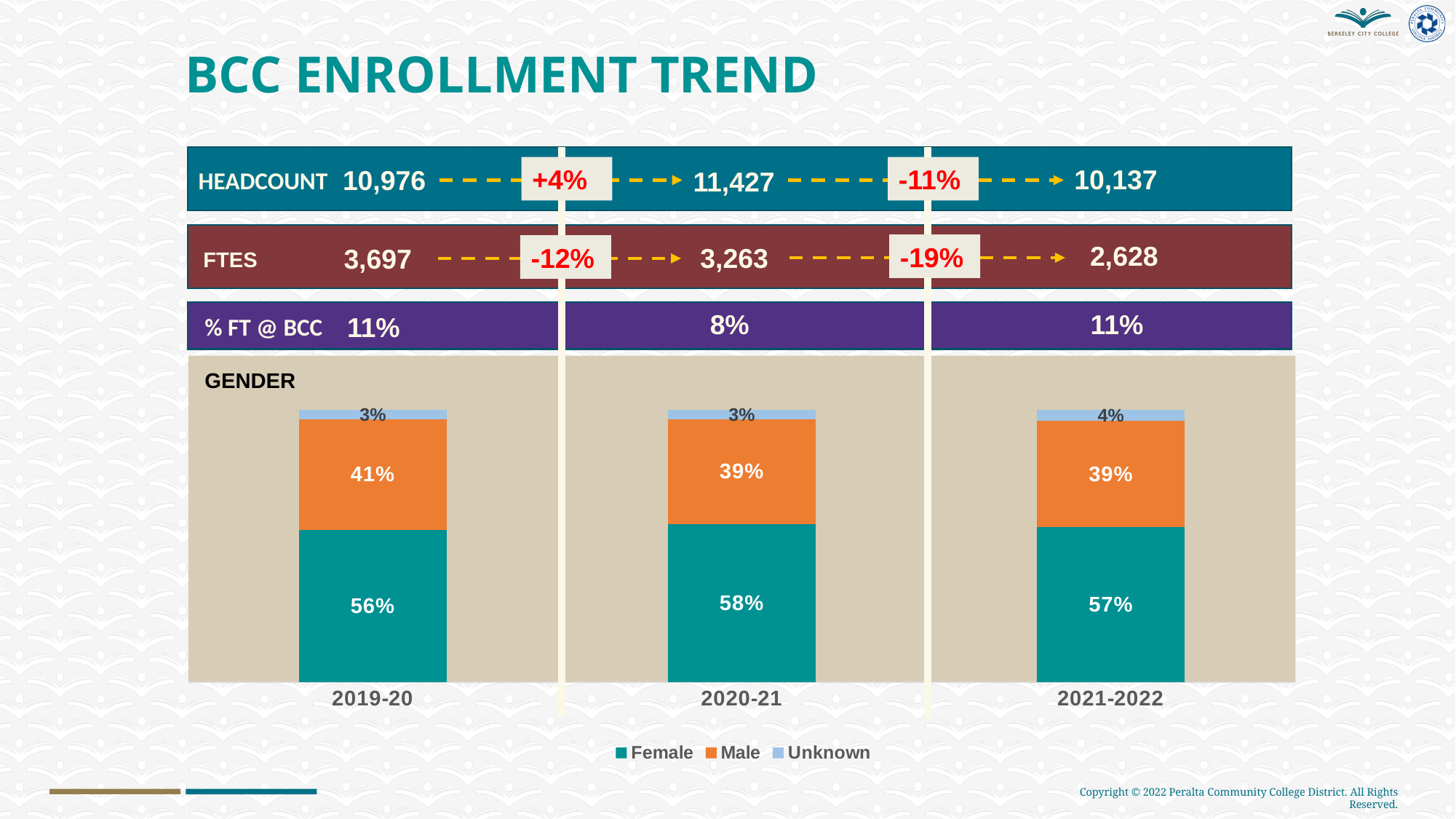
How many academic years are shown on the x axis of the GENDER chart? 3 In the GENDER chart, which year has the highest Female share? 2020-21 In the GENDER chart, what is the Male share for 2019-20? 41% What type of chart is the GENDER chart? stacked bar chart In the GENDER chart, what is the difference between the Female and Male shares in 2021-2022? 18% In the GENDER chart, what is the total of the three segments for the 2019-20 bar? 100% In the GENDER chart, what is the Female share for 2020-21? 58% In the GENDER chart, is the Male share larger in 2019-20 or in 2020-21? 2019-20 In the GENDER chart, which year has the lowest Female share? 2019-20 In the GENDER chart, what is the Unknown share for 2021-2022? 4% How many series does the legend of the GENDER chart list? 3 Which legend entry in the GENDER chart is shown in orange? Male